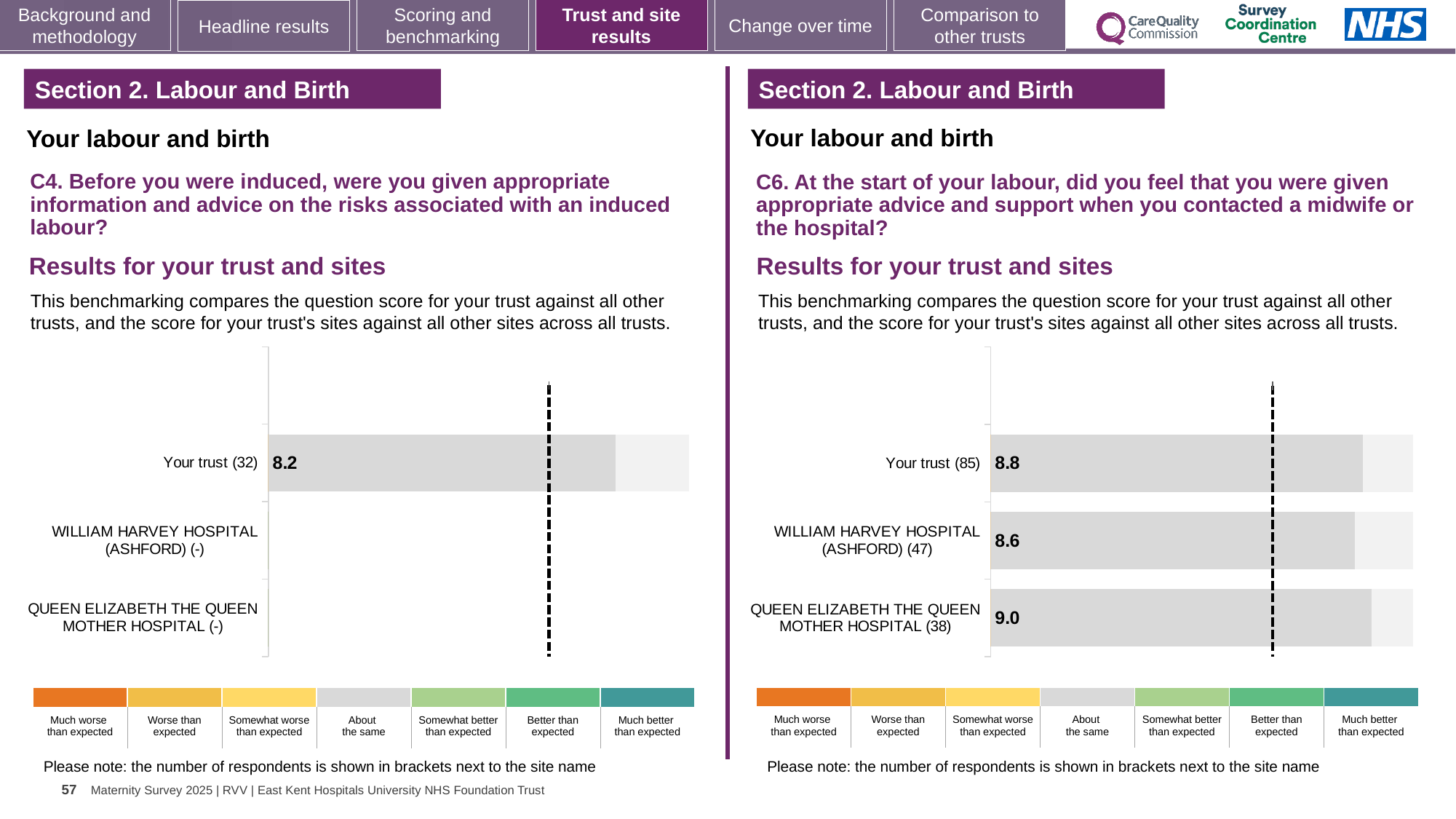
In the C6 chart on the right, which site or trust has the highest score? QUEEN ELIZABETH THE QUEEN MOTHER HOSPITAL How many categories (trust and sites) are listed in the C4 chart on the left? 3 In the C6 chart on the right, what is the score for QUEEN ELIZABETH THE QUEEN MOTHER HOSPITAL? 9.0 In the C4 chart on the left, what is the score for Your trust? 8.2 What kind of chart is the C6 chart on the right? Bar chart In the C6 chart on the right, which has the larger score: Your trust or WILLIAM HARVEY HOSPITAL (ASHFORD)? Your trust In the C6 chart on the right, which site or trust has the lowest score? WILLIAM HARVEY HOSPITAL (ASHFORD) In the C6 chart on the right, what is the difference between the score for QUEEN ELIZABETH THE QUEEN MOTHER HOSPITAL and the score for WILLIAM HARVEY HOSPITAL (ASHFORD)? 0.4 In the C6 chart on the right, what is the score for WILLIAM HARVEY HOSPITAL (ASHFORD)? 8.6 In the C4 chart on the left, how many respondents are shown in brackets for Your trust? 32 In the C6 chart on the right, what is the score for Your trust? 8.8 In the C6 chart on the right, how many respondents are shown in brackets for Your trust? 85